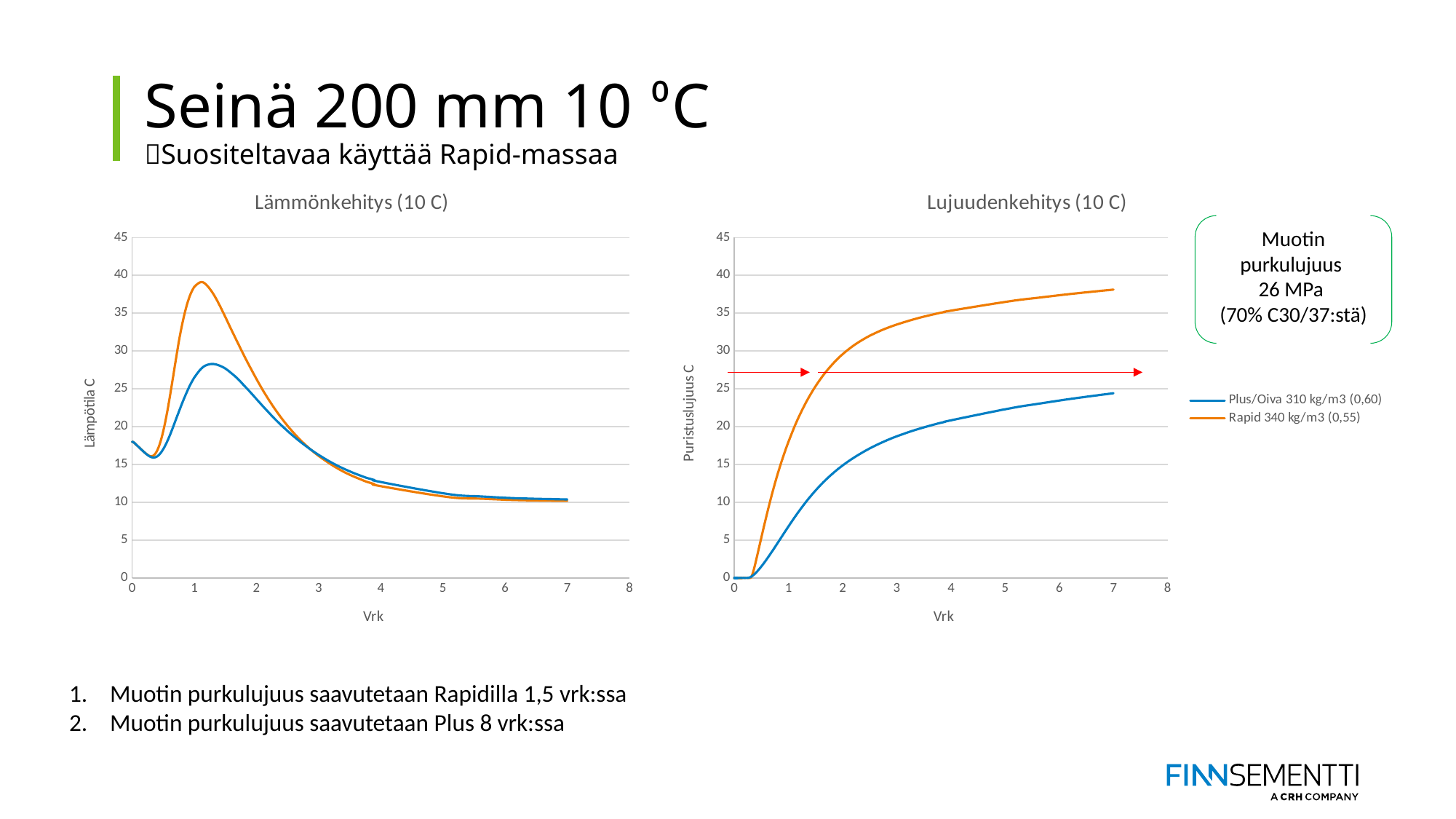
In the 'Lujuudenkehitys (10 C)' chart, which series has the higher value at 7 Vrk? Rapid 340 kg/m3 (0,55) In the 'Lämmönkehitys (10 C)' chart, which series reaches the higher peak temperature? Rapid 340 kg/m3 (0,55) What kind of chart is the 'Lämmönkehitys (10 C)' chart on the left? line chart In the 'Lämmönkehitys (10 C)' chart, is the peak value of the Plus/Oiva 310 kg/m3 (0,60) series greater or less than 30? less In the 'Lujuudenkehitys (10 C)' chart, do the values of both series rise or fall as Vrk increases? rise How many series does the legend list for the charts? 2 What is the x-axis label of the 'Lujuudenkehitys (10 C)' chart? Vrk In the 'Lujuudenkehitys (10 C)' chart, is the value of the Rapid 340 kg/m3 (0,55) series at 7 Vrk greater or less than 35? greater In the 'Lämmönkehitys (10 C)' chart, is the peak value of the Rapid 340 kg/m3 (0,55) series greater or less than 35? greater What is the y-axis label of the 'Lämmönkehitys (10 C)' chart? Lämpötila C What kind of chart is the 'Lujuudenkehitys (10 C)' chart on the right? line chart